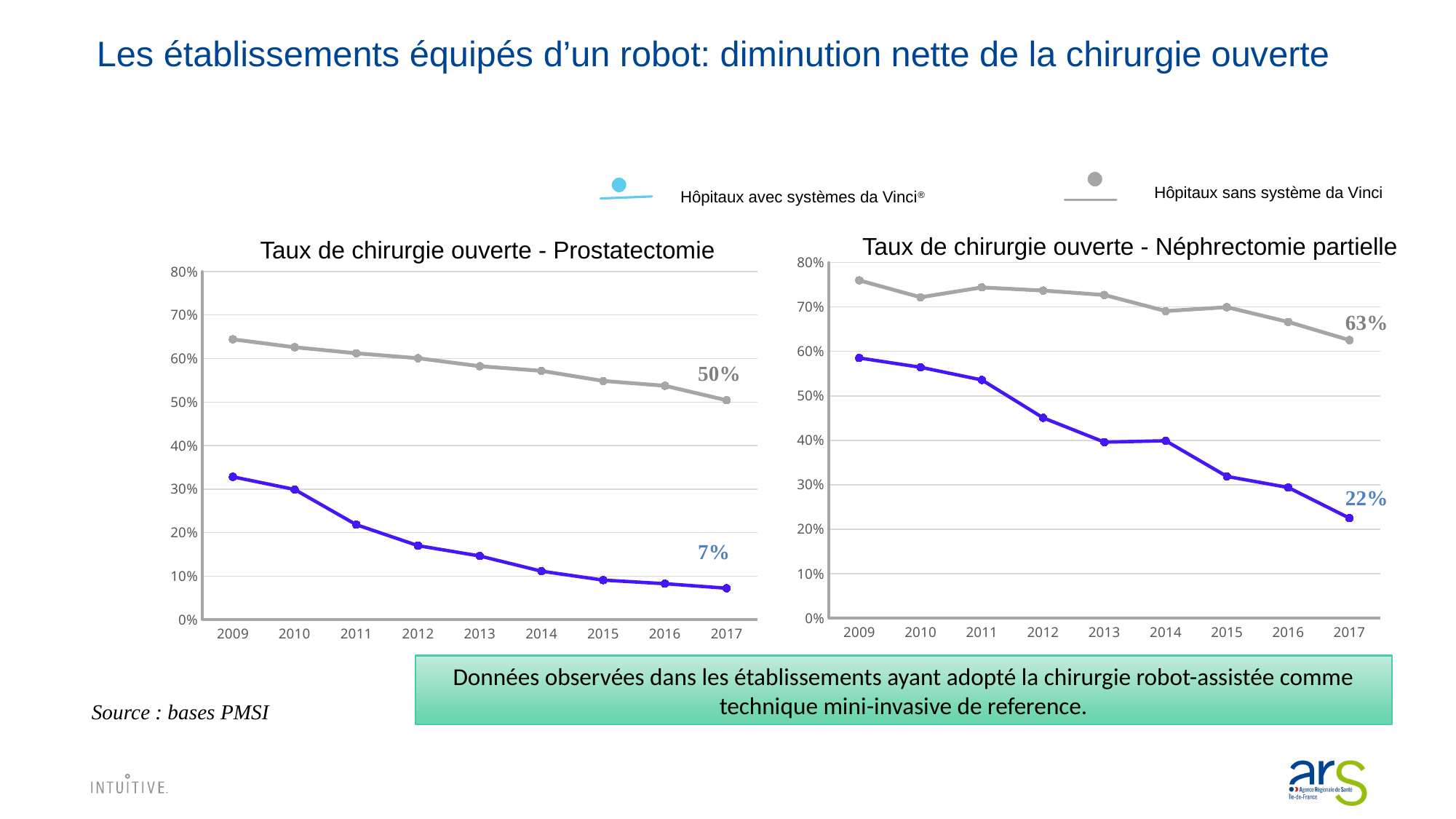
In the chart titled "Taux de chirurgie ouverte - Néphrectomie partielle", is the 2009 value for hospitals without a da Vinci system greater or less than 70%? greater In the chart titled "Taux de chirurgie ouverte - Prostatectomie", is the 2009 value for hospitals with da Vinci systems greater or less than 30%? greater How many years are shown on the x axis of the chart titled "Taux de chirurgie ouverte - Prostatectomie"? 9 In the chart titled "Taux de chirurgie ouverte - Néphrectomie partielle", what is the 2017 value for hospitals with da Vinci systems? 22% What kind of chart is the chart titled "Taux de chirurgie ouverte - Néphrectomie partielle"? line chart In the chart titled "Taux de chirurgie ouverte - Prostatectomie", what is the 2017 value for hospitals without a da Vinci system? 50% In the chart titled "Taux de chirurgie ouverte - Prostatectomie", what is the difference between the 2017 values of the two series? 43% In the chart titled "Taux de chirurgie ouverte - Prostatectomie", do the values for hospitals with da Vinci systems rise or fall from 2009 to 2017? fall In the chart titled "Taux de chirurgie ouverte - Prostatectomie", what is the 2017 value for hospitals with da Vinci systems? 7% In the chart titled "Taux de chirurgie ouverte - Néphrectomie partielle", which series has the higher value in 2017? Hôpitaux sans système da Vinci In the chart titled "Taux de chirurgie ouverte - Néphrectomie partielle", what is the difference between the 2017 values of the two series? 40% In the chart titled "Taux de chirurgie ouverte - Néphrectomie partielle", what is the 2017 value for hospitals without a da Vinci system? 63%